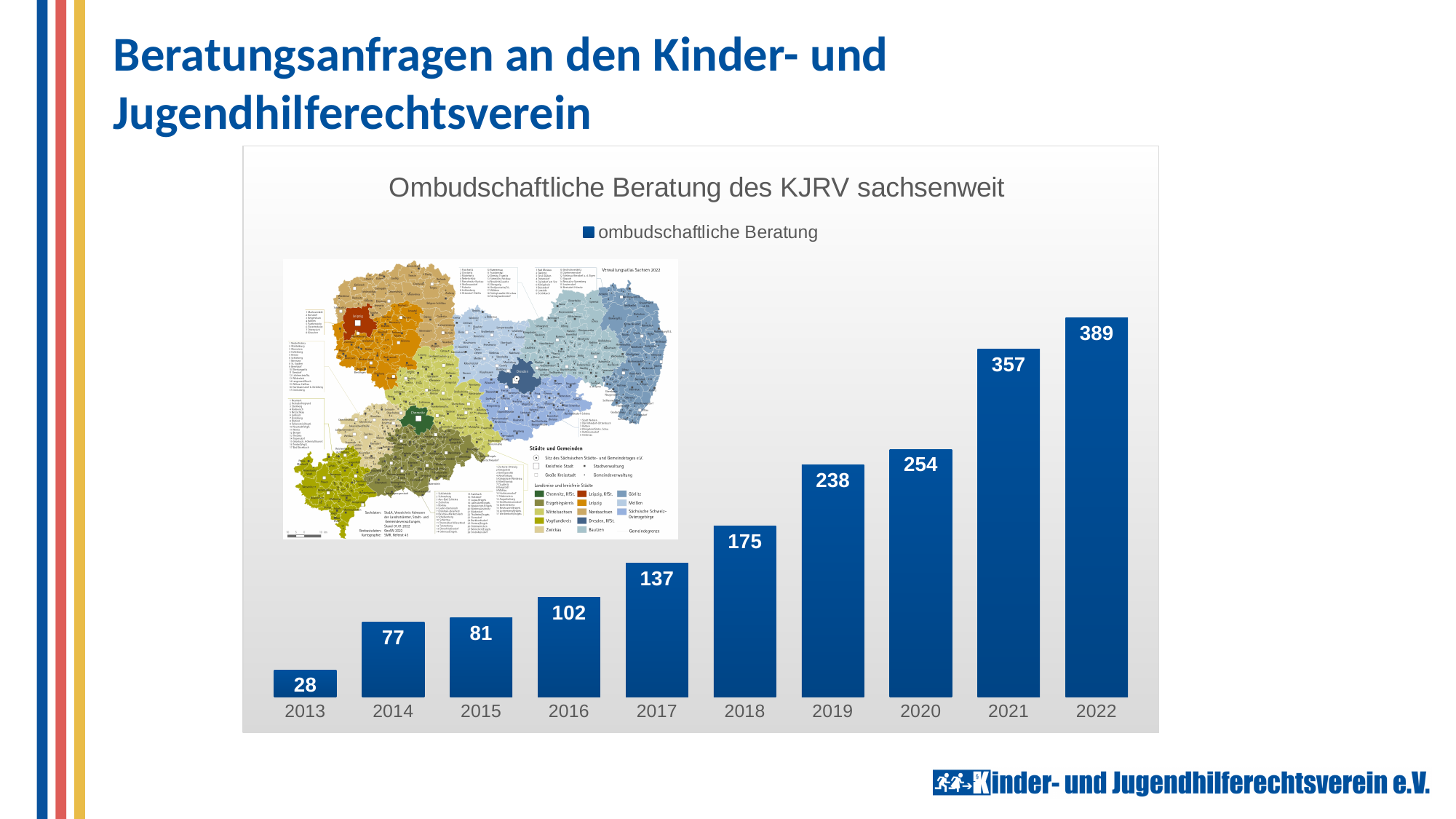
Which year has the highest value in the chart? 2022 What is the difference between the values for 2022 and 2021? 32 What is the difference between the values for 2019 and 2018? 63 What is the value for 2013 in the chart? 28 What is the value for 2021 in the chart? 357 Which year has the lowest value in the chart? 2013 Which is larger, the value for 2016 or the value for 2015? 2016 How many years are shown on the x axis of the chart? 10 What is the value for 2018 in the chart? 175 Do the values rise or fall from 2013 to 2022? rise How many series does the legend list? 1 What kind of chart is shown on the slide? bar chart